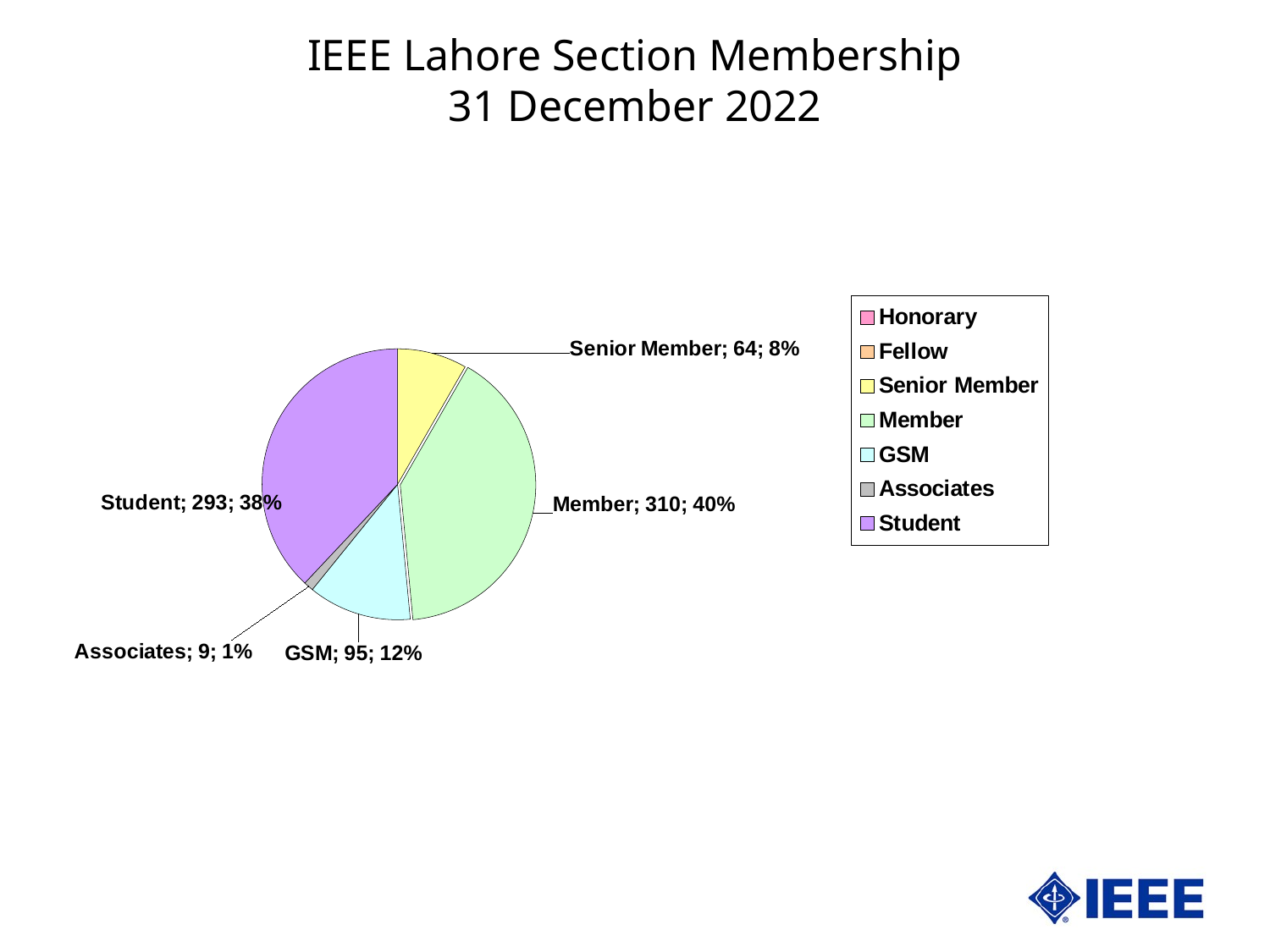
How many entries does the legend list? 7 What share of the pie does the GSM slice represent? 12% How many members are in the Member category? 310 How many members are in the Senior Member category? 64 How many members are in the GSM category? 95 What share of the pie does the Student slice represent? 38% How many members are in the Student category? 293 Which is larger, the GSM count or the Senior Member count? GSM What type of chart is shown on the slide? pie chart Which labelled category has the smallest slice of the pie? Associates Which category has the largest slice of the pie? Member What is the difference between the Member count and the Student count? 17